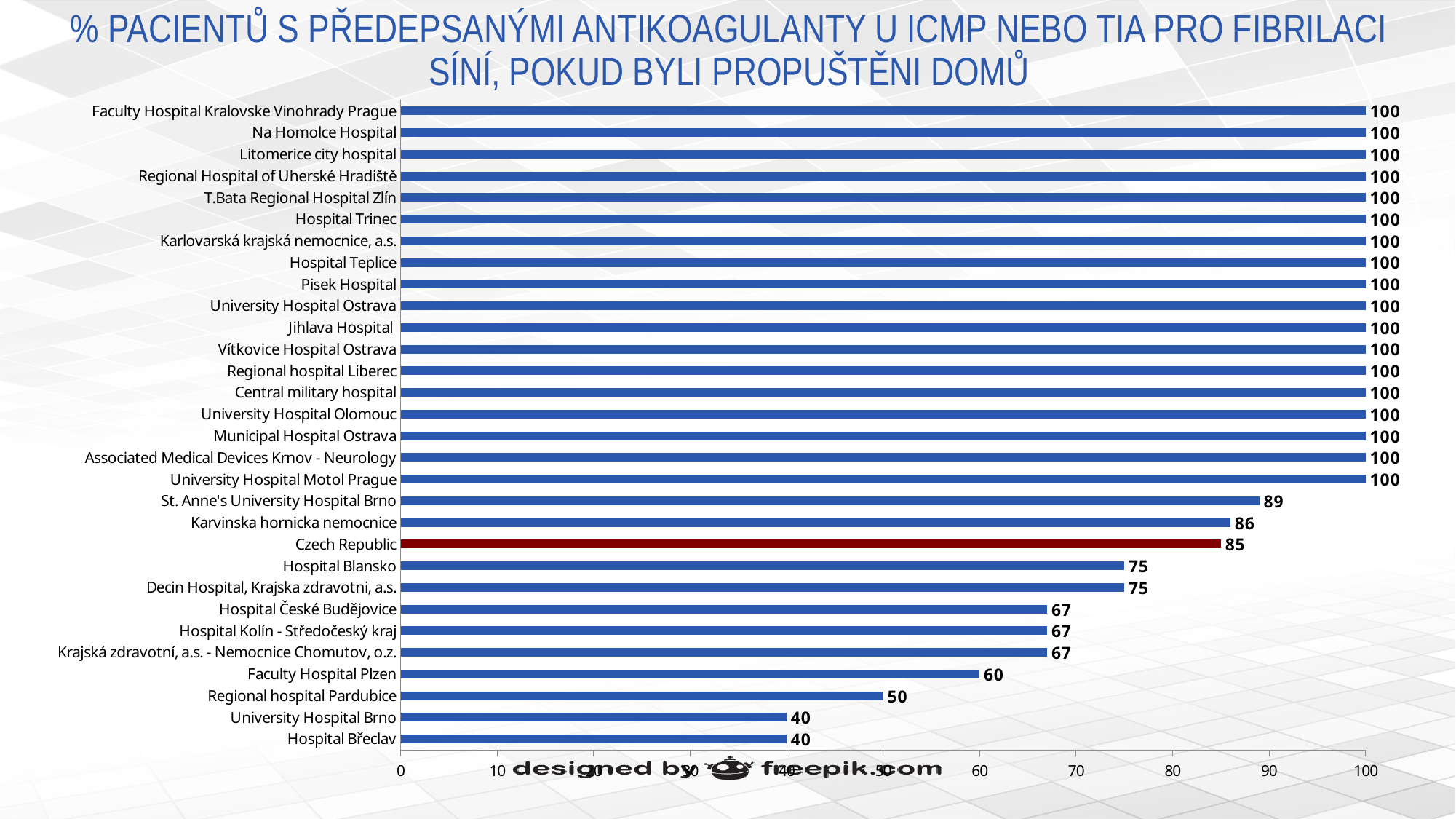
What is the value for Regional hospital Pardubice? 50 Is the value for Regional hospital Pardubice greater or less than 60? less What is the difference between the values for St. Anne's University Hospital Brno and University Hospital Brno? 49 What is the value for St. Anne's University Hospital Brno? 89 What is the value for Faculty Hospital Plzen? 60 Which category's bar is drawn in a different colour (dark red) from the others? Czech Republic What kind of chart is shown on the slide? bar chart What is the difference between the values for Czech Republic and Hospital Blansko? 10 What is the value for Czech Republic? 85 What is the value for Karvinska hornicka nemocnice? 86 How many categories are shown in the chart? 30 Which is larger, the value for Hospital České Budějovice or the value for Faculty Hospital Plzen? Hospital České Budějovice